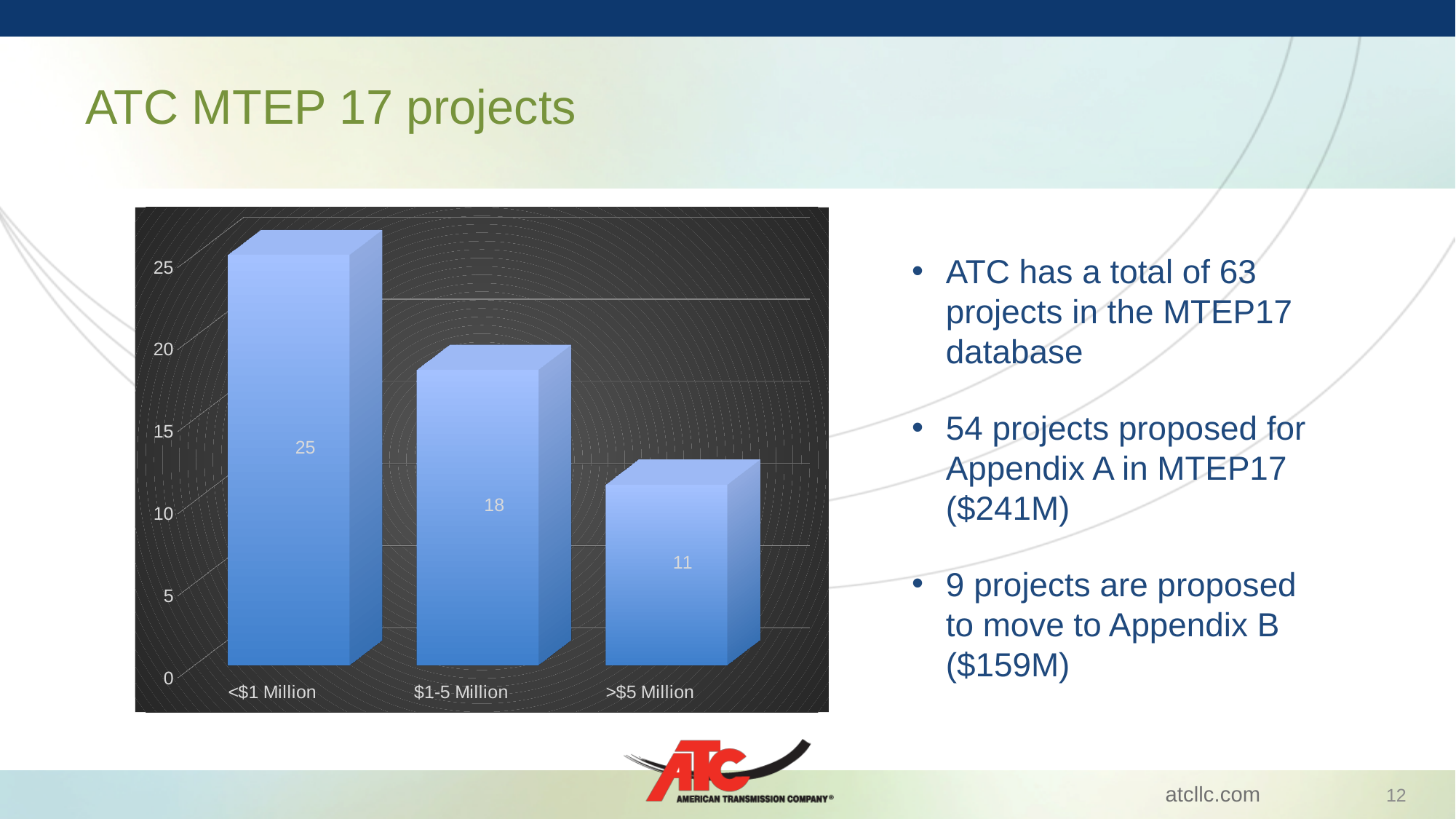
Which is larger, the value for $1-5 Million or the value for >$5 Million? $1-5 Million Is the value for $1-5 Million greater or less than 20? less What is the value for the $1-5 Million category? 18 Do the values rise or fall from left to right along the x axis? fall How many categories are shown on the chart? 3 Which category has the highest value? <$1 Million Which category has the lowest value? >$5 Million What kind of chart is shown on the slide? bar chart What is the value for the <$1 Million category? 25 What is the difference between the values for <$1 Million and >$5 Million? 14 What is the value for the >$5 Million category? 11 What is the difference between the values for <$1 Million and $1-5 Million? 7